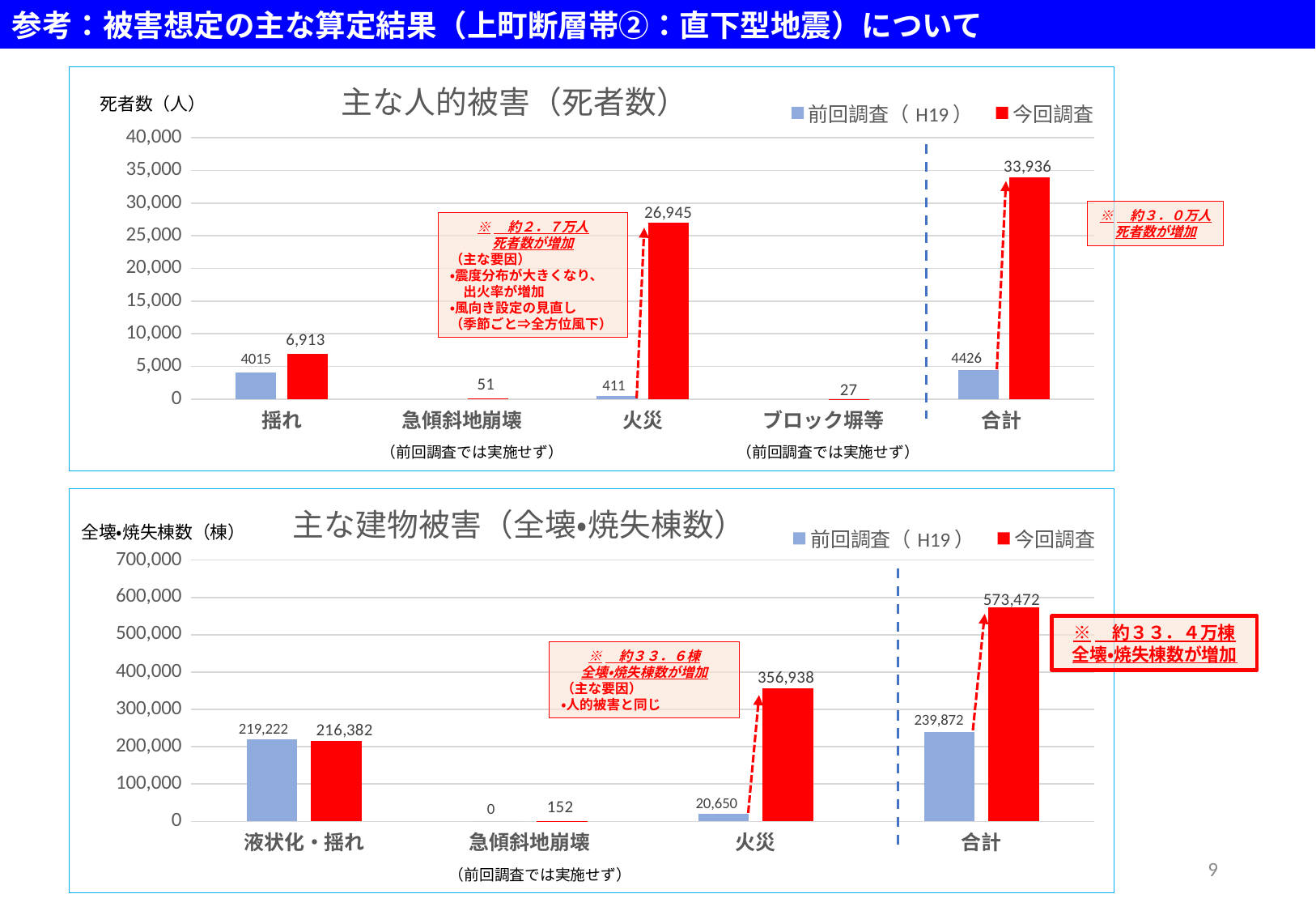
In the chart titled 主な人的被害（死者数）, excluding 合計, which category has the highest 今回調査 value? 火災 In the chart titled 主な建物被害（全壊・焼失棟数）, what is the 前回調査（H19） value for 合計? 239,872 In the chart titled 主な建物被害（全壊・焼失棟数）, which is larger for 液状化・揺れ: the 前回調査（H19） value or the 今回調査 value? 前回調査（H19） In the chart titled 主な人的被害（死者数）, how many series does the legend list? 2 In the chart titled 主な人的被害（死者数）, what is the difference between the 今回調査 and 前回調査（H19） values for 揺れ? 2,898 In the chart titled 主な人的被害（死者数）, what is the 今回調査 value for 合計? 33,936 In the chart titled 主な建物被害（全壊・焼失棟数）, what is the 今回調査 value for 火災? 356,938 In the chart titled 主な人的被害（死者数）, how many categories are shown on the x axis? 5 In the chart titled 主な人的被害（死者数）, what is the 前回調査（H19） value for 揺れ? 4015 In the chart titled 主な建物被害（全壊・焼失棟数）, what is the difference between the 今回調査 and 前回調査（H19） values for 合計? 333,600 What type of chart is the chart titled 主な建物被害（全壊・焼失棟数）? Bar chart In the chart titled 主な人的被害（死者数）, what is the 今回調査 value for 火災? 26,945